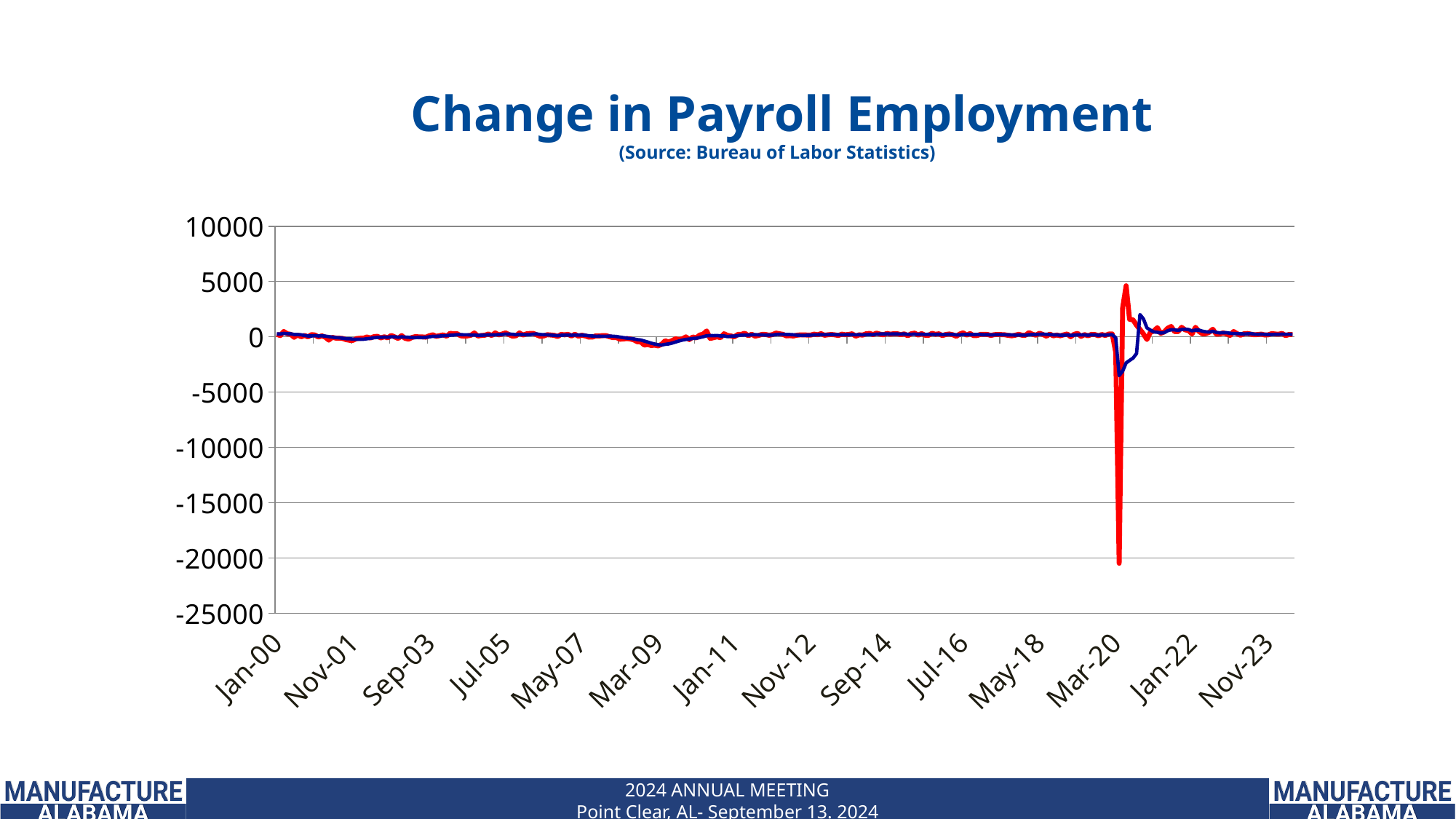
Near which x-axis label does the sharp drop in both lines occur? Mar-20 Which line reaches a lower minimum value, the red line or the blue line? red line Is the value of the red line at Jan-11 greater or less than -5000? greater What source is cited under the chart title? Bureau of Labor Statistics How many labels are shown on the x axis? 14 Is the lowest point of the red line greater or less than -15000? less Is the lowest point of the blue line greater or less than -5000? greater How many lines (series) are plotted on the chart? 2 What is the title of the chart? Change in Payroll Employment What kind of chart is shown on the slide? line chart